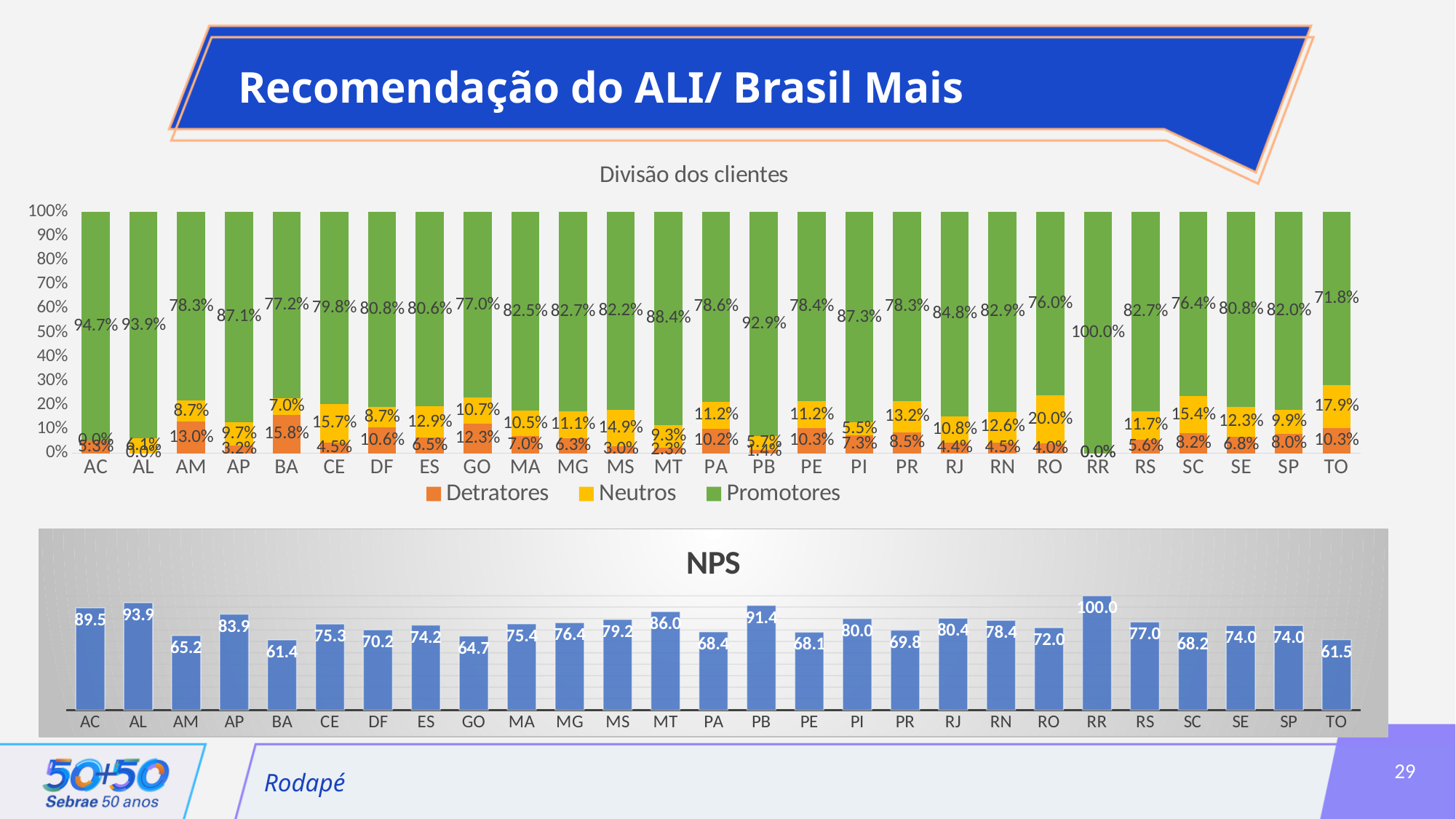
In the NPS chart, which state has the lowest NPS? BA In the 'Divisão dos clientes' chart, which is larger, the Promotores percentage for PB or for PE? PB In the 'Divisão dos clientes' chart, which state has the highest Neutros percentage? RO In the 'Divisão dos clientes' chart, which colour represents Promotores? Green In the 'Divisão dos clientes' chart, what is the Detratores percentage for BA? 15.8% In the 'Divisão dos clientes' chart, what is the Promotores percentage for TO? 71.8% In the NPS chart, what is the difference between the NPS of AL and the NPS of AM? 28.7 What kind of chart is the NPS chart? Bar chart In the NPS chart, which is larger, the NPS for MT or the NPS for PA? MT In the NPS chart, what is the NPS value for RR? 100.0 In the 'Divisão dos clientes' chart, how many series does the legend list? 3 In the NPS chart, how many states are shown on the x axis? 27